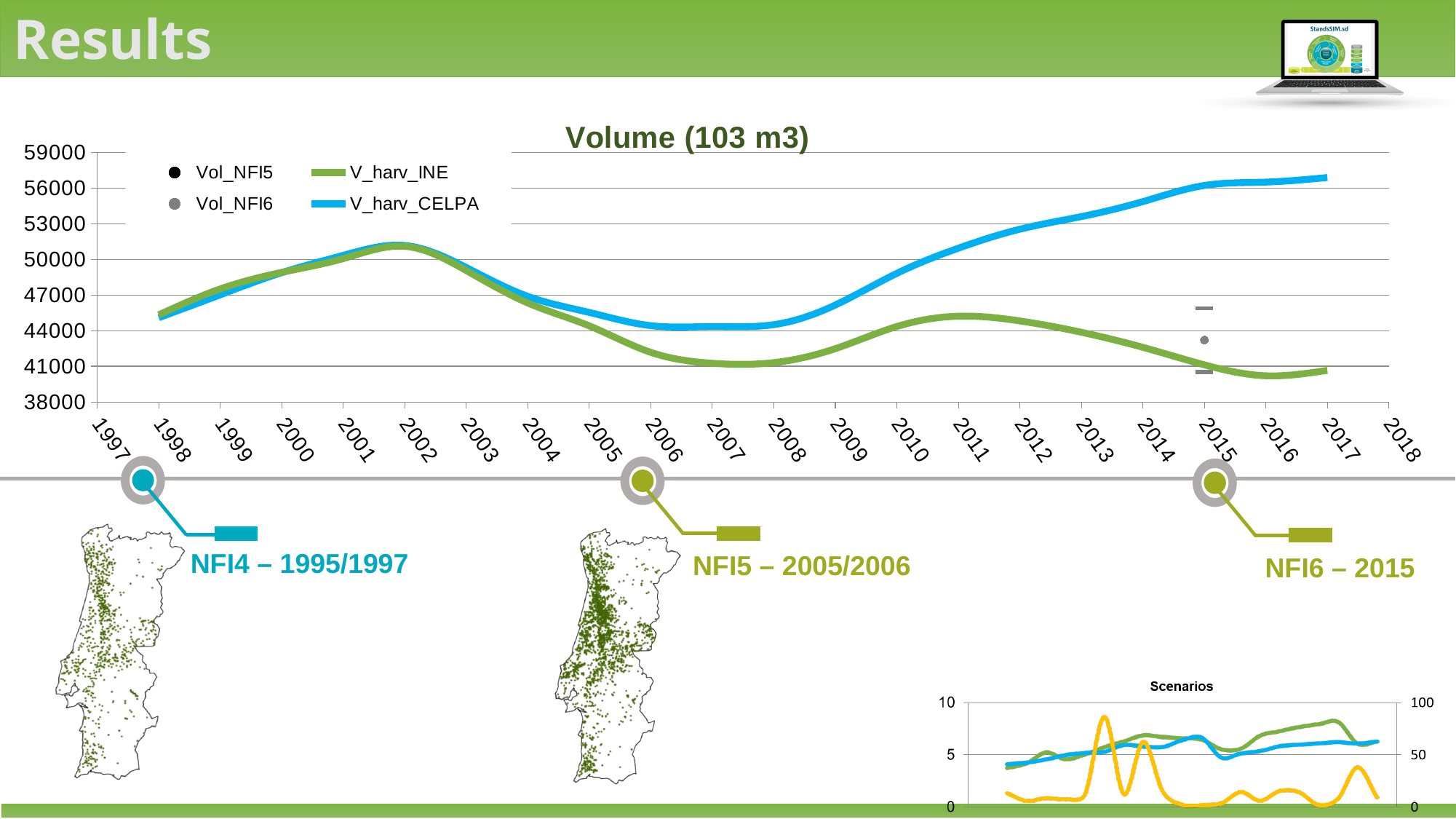
In the Volume (103 m3) chart, is the value of V_harv_INE in 2016 greater or less than 41000? less In the Volume (103 m3) chart, is the value of V_harv_CELPA in 2007 greater or less than 47000? less In the Volume (103 m3) chart, is the value of V_harv_CELPA in 2017 greater or less than 53000? greater What is the title of the small chart at the bottom right of the slide? Scenarios In the Volume (103 m3) chart, which series is higher in 2017, V_harv_INE or V_harv_CELPA? V_harv_CELPA In the Volume (103 m3) chart, how many series does the legend list? 4 In the Volume (103 m3) chart, does V_harv_CELPA rise or fall between 2007 and 2017? rise What is the title of the large chart on the slide? Volume (103 m3) In the Volume (103 m3) chart, what kind of chart is shown? line chart In the Volume (103 m3) chart, does V_harv_INE rise or fall between 2011 and 2016? fall